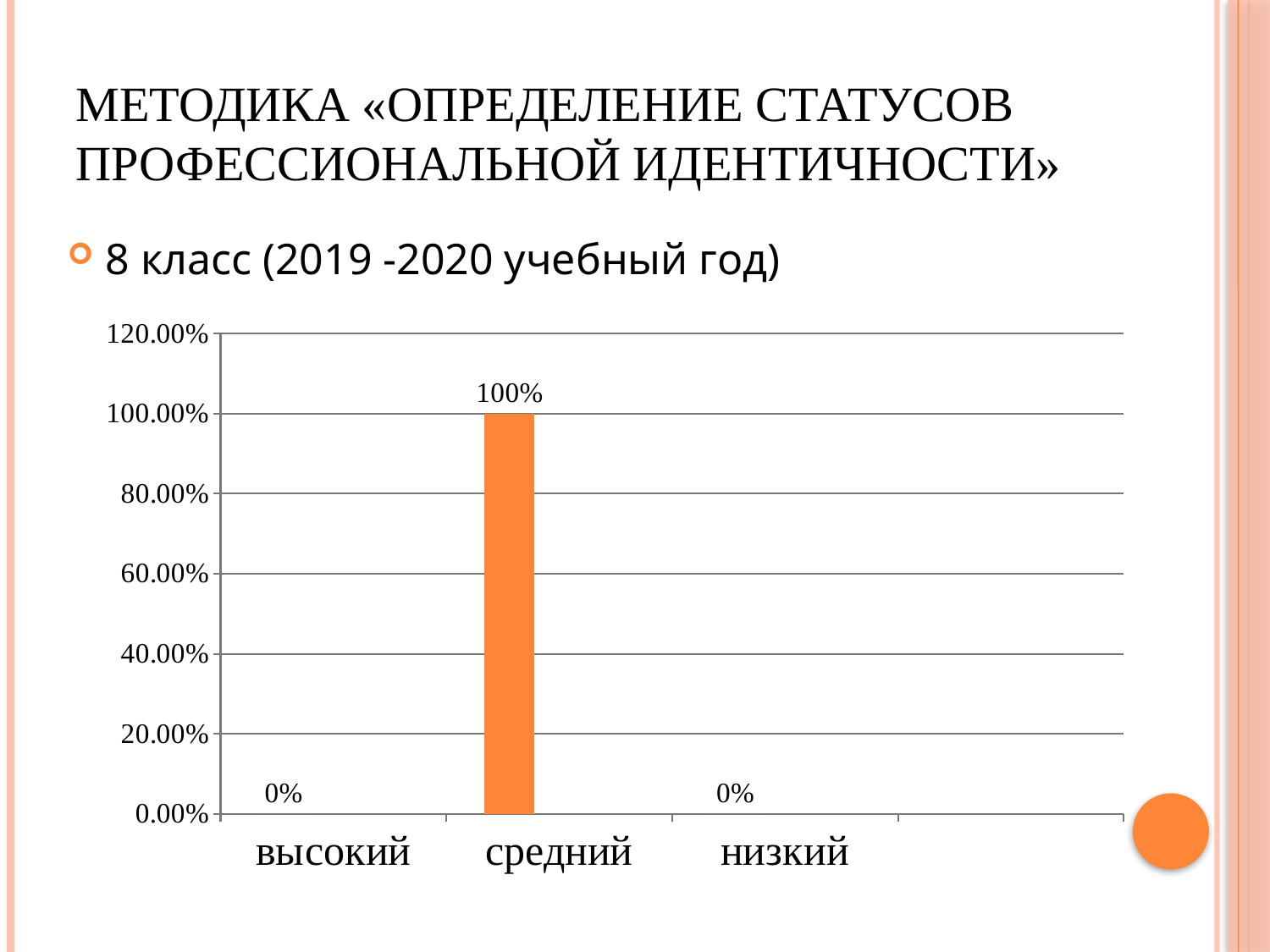
What is the value for низкий? 0% What is the highest tick value shown on the y axis? 120.00% What kind of chart is shown on the slide? bar chart Which is larger, the value for средний or the value for низкий? средний Is the value for средний greater or less than 80.00%? greater How many categories are shown on the x axis? 3 What is the difference between the values for средний and высокий? 100% What colour is the bar for средний? orange Which category has the highest value? средний What is the value for высокий? 0% What is the value for средний? 100%